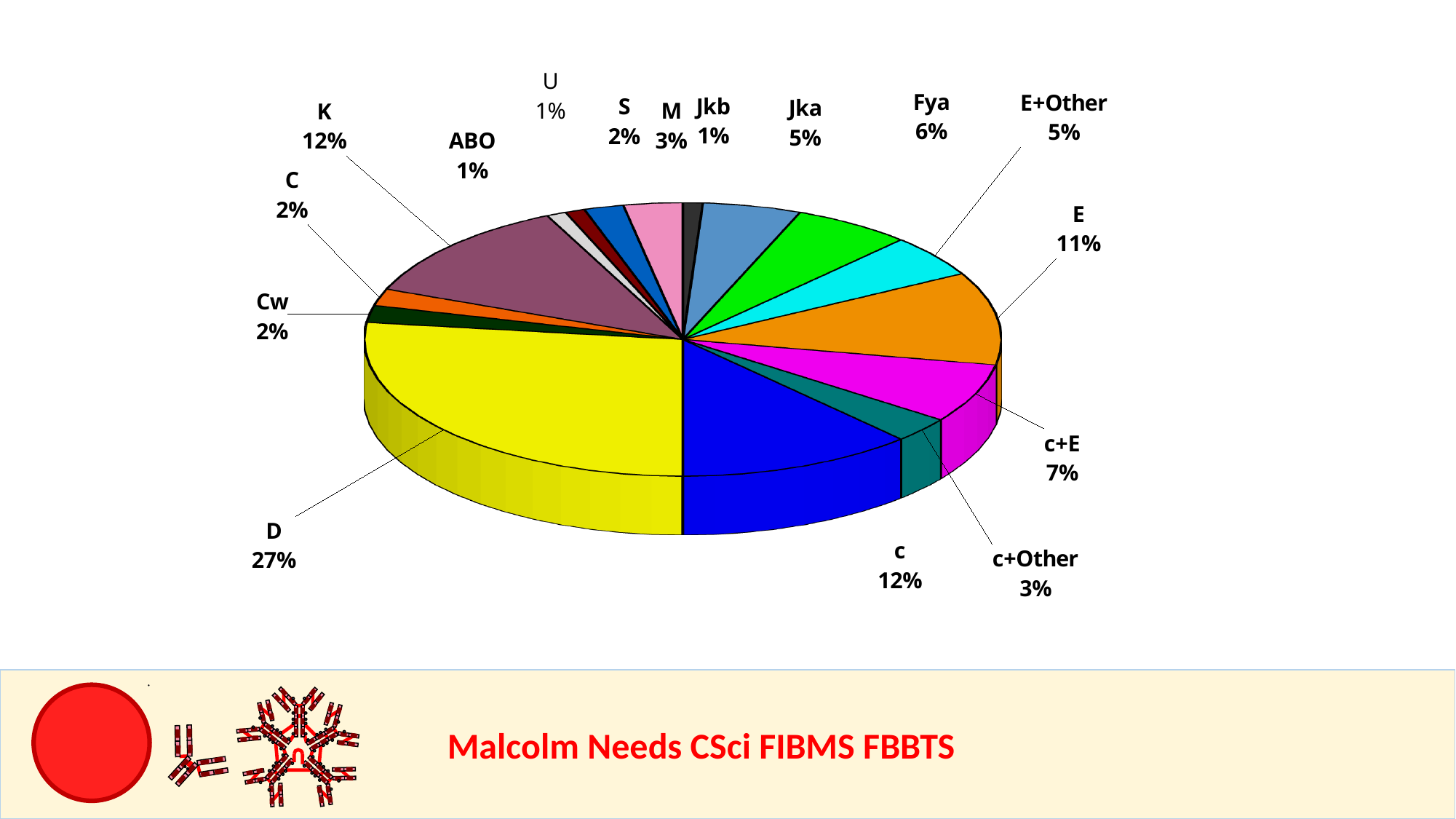
What percentage is shown for M? 3% What percentage is shown for E? 11% What percentage is shown for K? 12% What colour is the slice for D? yellow What percentage is shown for c+E? 7% Which is larger, the slice for E or the slice for Jka? E What percentage is shown for Fya? 6% What percentage is shown for D? 27% What kind of chart is shown on the slide? pie chart Which category has the largest slice of the pie? D What is the difference in percentage points between D and c? 15 How many categories are labelled on the pie chart? 16